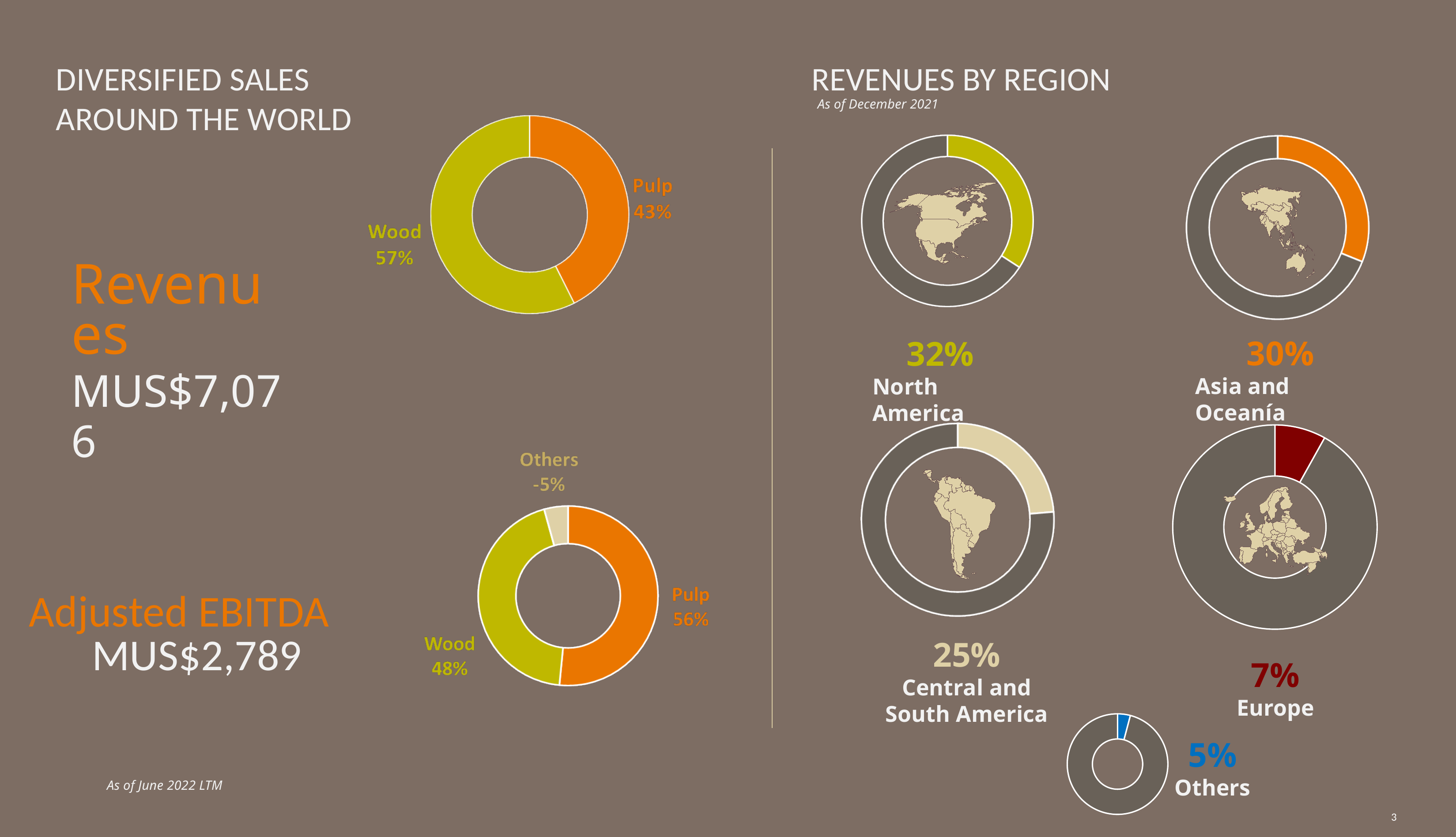
How many segments are labelled in the Adjusted EBITDA donut chart (bottom left)? 3 What type of chart is used to show the Revenues split between Wood and Pulp (top left)? Donut (pie) chart In the Revenues by Region section, what share of revenues comes from North America? 32% In the Revenues donut chart (top left), what share does Wood account for? 57% In the Adjusted EBITDA donut chart (bottom left), which segment is the largest? Pulp In the Revenues by Region section, what is the difference in percentage points between Asia and Oceanía and Europe? 23 In the Revenues donut chart (top left), what is the difference in percentage points between Wood and Pulp? 14 In the Revenues by Region section, which region has the smallest share of revenues? Others In the Adjusted EBITDA donut chart (bottom left), what value is shown for Others? -5% In the Revenues donut chart (top left), what share does Pulp account for? 43% In the Revenues donut chart (top left), which segment is larger, Wood or Pulp? Wood In the Adjusted EBITDA donut chart (bottom left), what share does Pulp account for? 56%